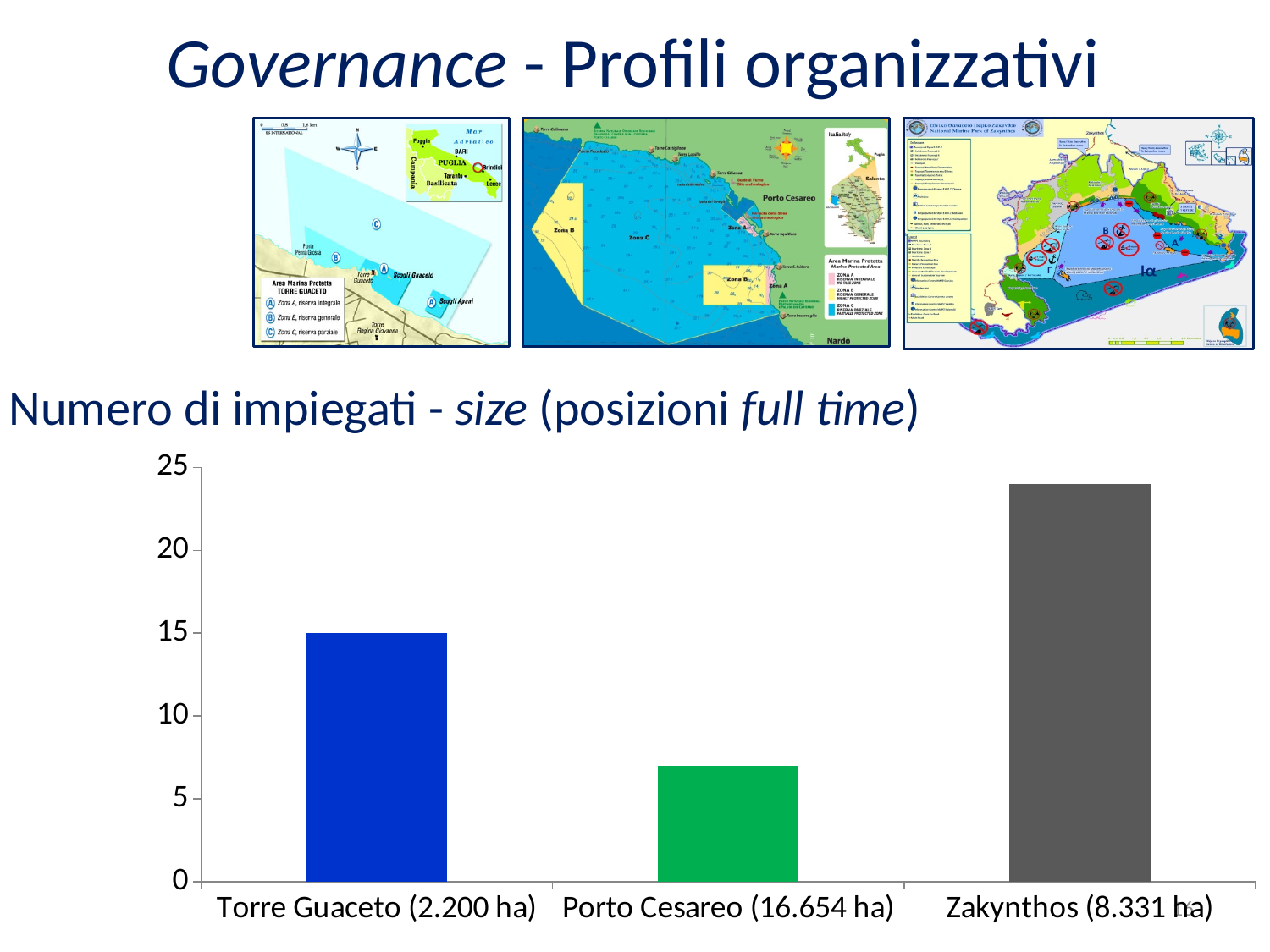
What colour is the bar for Porto Cesareo (16.654 ha)? green Which category has the highest bar in the chart? Zakynthos (8.331 ha) Is the value for Porto Cesareo (16.654 ha) greater or less than 10? less What is the maximum value shown on the y axis of the chart? 25 What is the value for Torre Guaceto (2.200 ha) in the chart? 15 What type of chart is shown on the slide? bar chart Is the value for Porto Cesareo (16.654 ha) greater or less than 5? greater How many categories are shown on the x axis of the chart? 3 Which is larger, the value for Torre Guaceto (2.200 ha) or the value for Porto Cesareo (16.654 ha)? Torre Guaceto (2.200 ha) Which category has the lowest bar in the chart? Porto Cesareo (16.654 ha) Is the value for Zakynthos (8.331 ha) greater or less than 20? greater Which is larger, the value for Torre Guaceto (2.200 ha) or the value for Zakynthos (8.331 ha)? Zakynthos (8.331 ha)